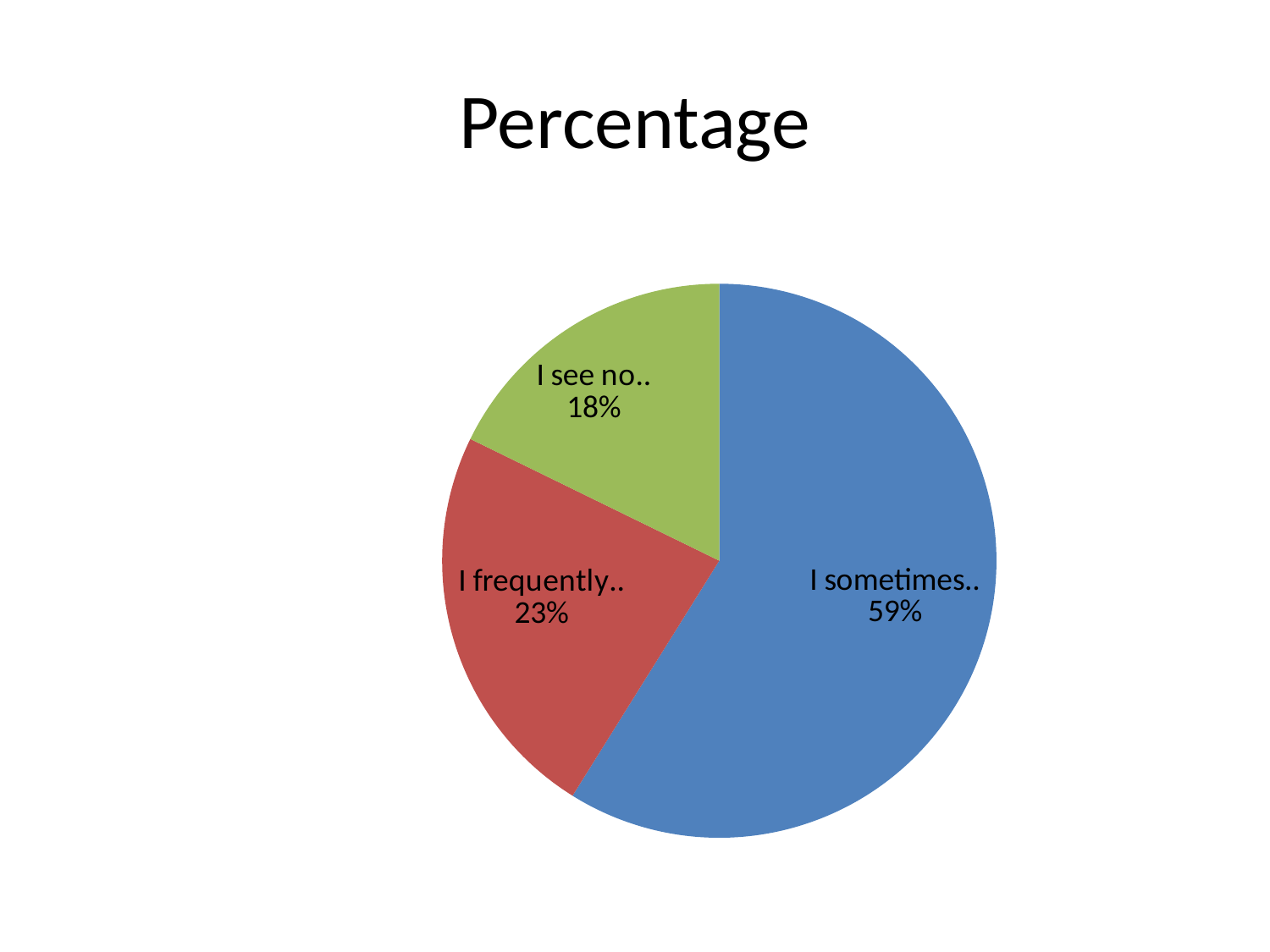
What is the difference in percentage points between the "I frequently.." slice and the "I see no.." slice? 5 Which slice has the largest share of the pie? I sometimes.. What is the difference in percentage points between the "I sometimes.." slice and the "I frequently.." slice? 36 Which slice is larger, "I frequently.." or "I see no.."? I frequently.. What colour is the "I sometimes.." slice? blue What percentage is shown for the slice labelled "I frequently.."? 23% What is the title of the chart? Percentage What percentage is shown for the slice labelled "I sometimes.."? 59% How many slices does the pie chart have? 3 Which slice has the smallest share of the pie? I see no.. What percentage is shown for the slice labelled "I see no.."? 18% What kind of chart is shown on the slide? pie chart